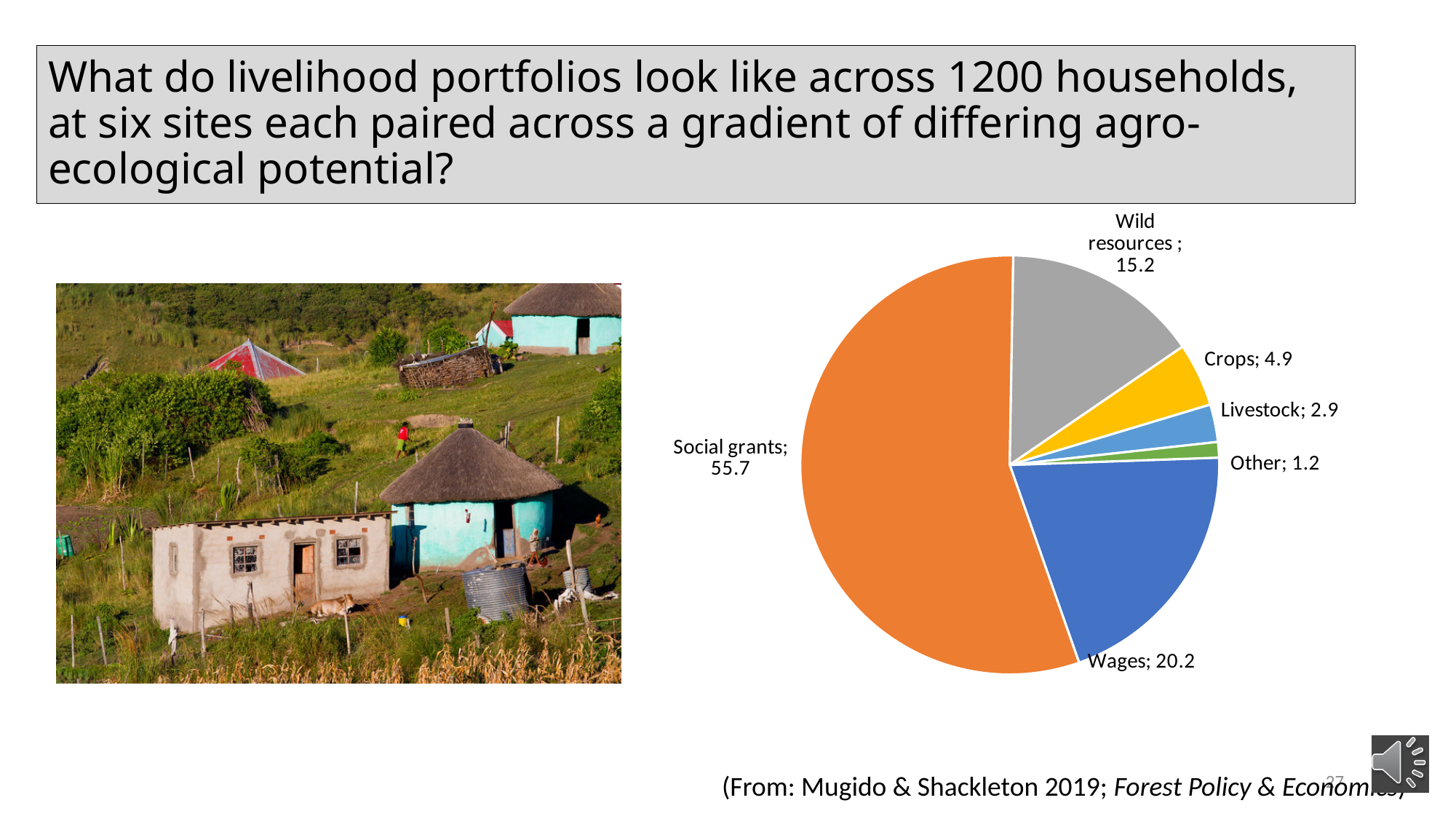
What is the difference between the values for Social grants and Wages? 35.5 What kind of chart is shown on the slide? Pie chart What is the value for Livestock in the pie chart? 2.9 What is the value for Wild resources in the pie chart? 15.2 Which is larger, the value for Crops or the value for Livestock? Crops What is the value for Wages in the pie chart? 20.2 Which category has the largest slice of the pie chart? Social grants What is the value for Social grants in the pie chart? 55.7 Which category has the smallest slice of the pie chart? Other What colour is the Social grants slice in the pie chart? Orange What is the value for Crops in the pie chart? 4.9 How many categories are shown in the pie chart? 6